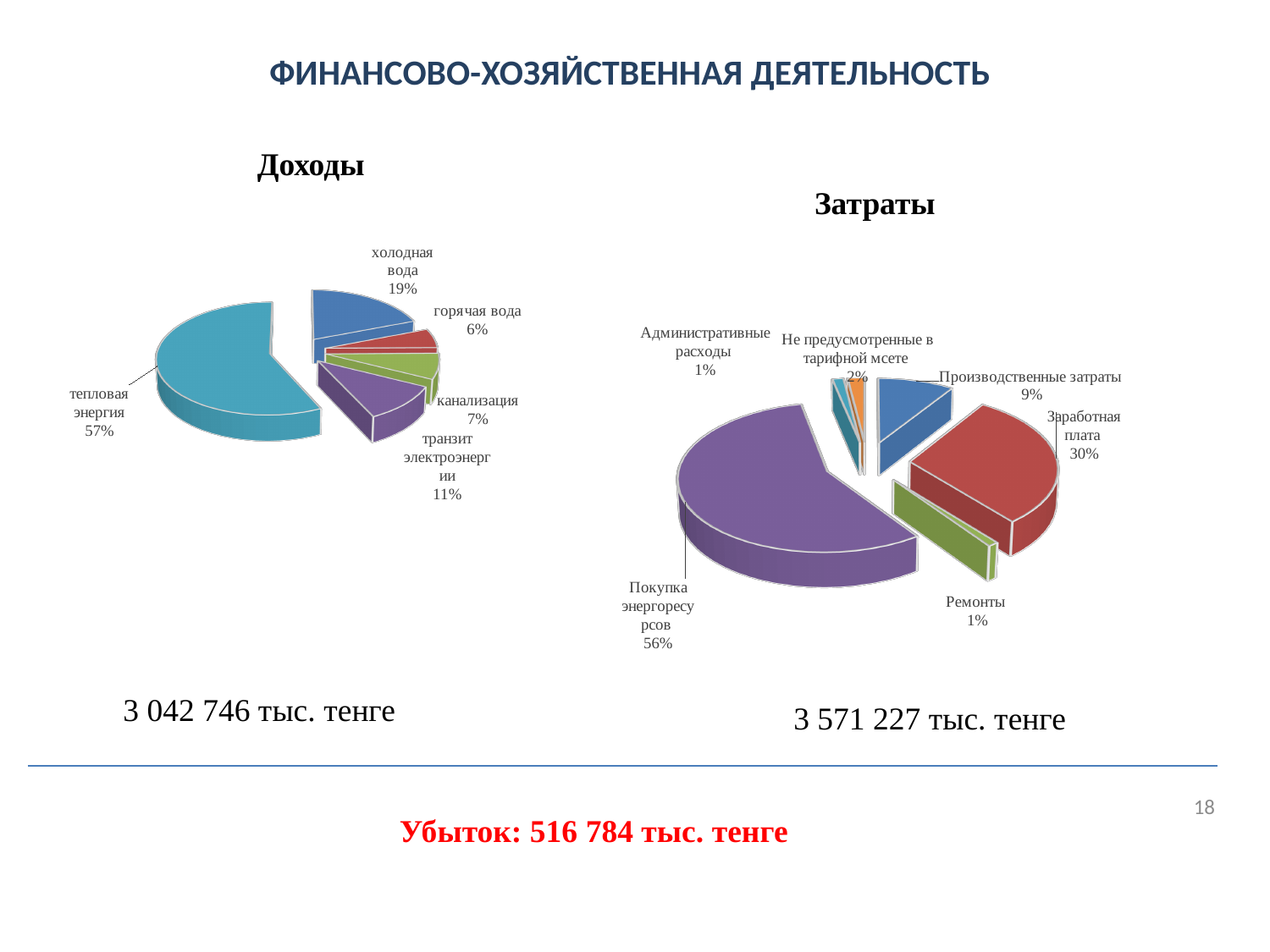
In the Доходы chart, which category has the smallest share? горячая вода What type of chart is the Затраты chart? pie chart In the Доходы chart, what is the difference between холодная вода and транзит электроэнергии? 8% In the Затраты chart, what is the value for Заработная плата? 30% In the Доходы chart, how many slices are there? 5 In the Доходы chart, what is the value for холодная вода? 19% In the Затраты chart, what share do Производственные затраты have? 9% In the Затраты chart, how many categories are shown? 6 What total amount is shown below the Доходы chart? 3 042 746 тыс. тенге In the Затраты chart, which is larger: Не предусмотренные в тарифной смете or Ремонты? Не предусмотренные в тарифной смете In the Затраты chart, which category has the largest share? Покупка энергоресурсов In the Доходы chart, what share does тепловая энергия have? 57%